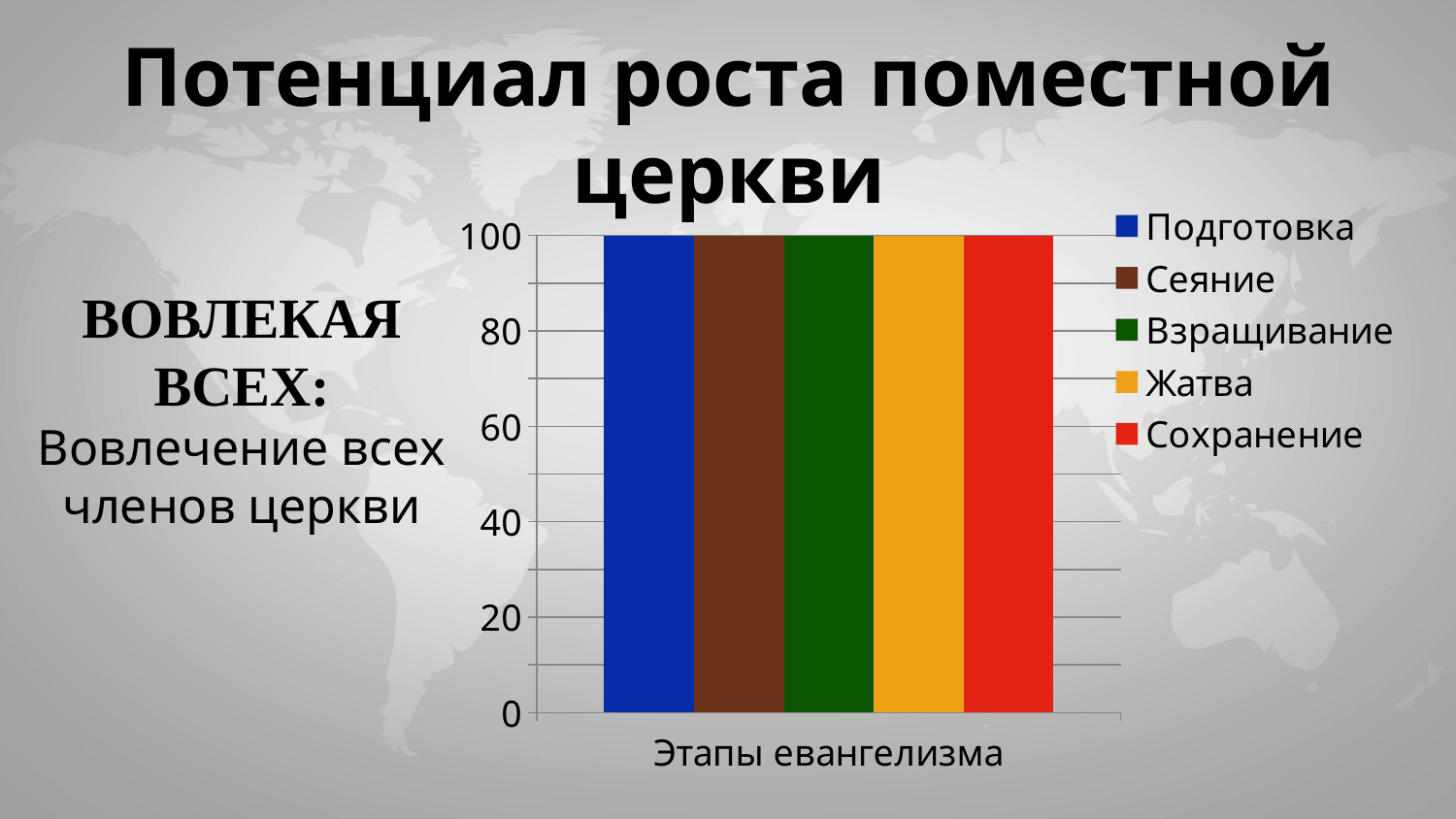
How many categories are shown on the x axis? 1 What is the value of the Сохранение bar? 100 What is the difference between the Подготовка and Сохранение values? 0 What is the value of the Взращивание bar? 100 What is the value of the Сеяние bar? 100 What is the value of the Жатва bar? 100 How many series does the legend list? 5 What kind of chart is shown on the slide? bar chart Is the value for Жатва greater or less than 80? greater Which series is shown in red in the legend? Сохранение What is the value of the Подготовка bar? 100 What is the label of the category on the x axis? Этапы евангелизма